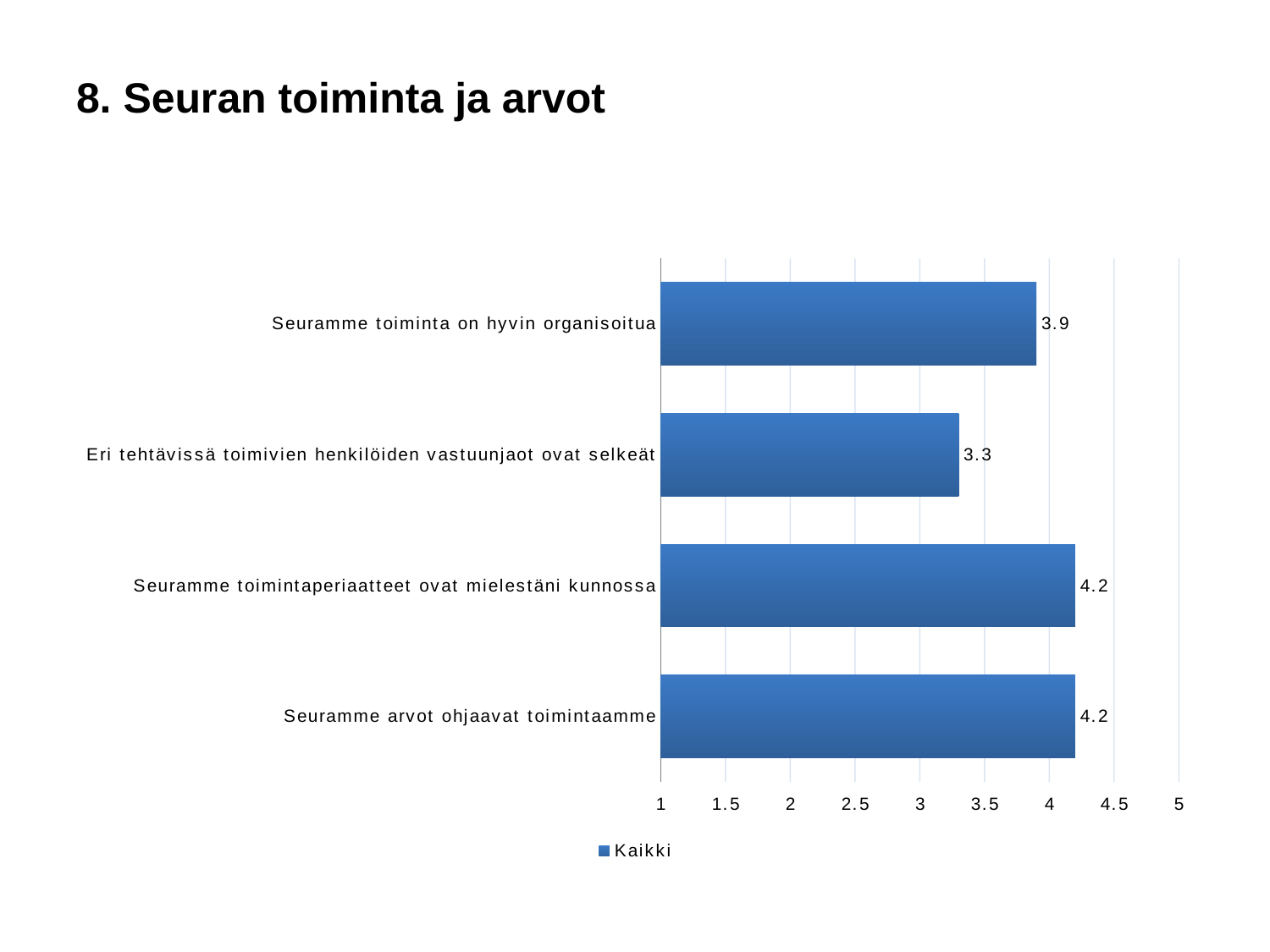
Which is larger: the value for "Seuramme toiminta on hyvin organisoitua" or for "Eri tehtävissä toimivien henkilöiden vastuunjaot ovat selkeät"? Seuramme toiminta on hyvin organisoitua What kind of chart is shown on the slide? bar chart What is the difference between the values for "Seuramme arvot ohjaavat toimintaamme" and "Seuramme toiminta on hyvin organisoitua"? 0.3 What is the value for "Eri tehtävissä toimivien henkilöiden vastuunjaot ovat selkeät"? 3.3 How many series does the legend list? 1 What is the name of the series shown in the legend? Kaikki Which category has the lowest value? Eri tehtävissä toimivien henkilöiden vastuunjaot ovat selkeät What is the difference between the values for "Seuramme toimintaperiaatteet ovat mielestäni kunnossa" and "Eri tehtävissä toimivien henkilöiden vastuunjaot ovat selkeät"? 0.9 What is the value for "Seuramme arvot ohjaavat toimintaamme"? 4.2 What is the value for "Seuramme toiminta on hyvin organisoitua"? 3.9 Is the value for "Eri tehtävissä toimivien henkilöiden vastuunjaot ovat selkeät" greater or less than 3.5? less How many categories are shown in the chart? 4